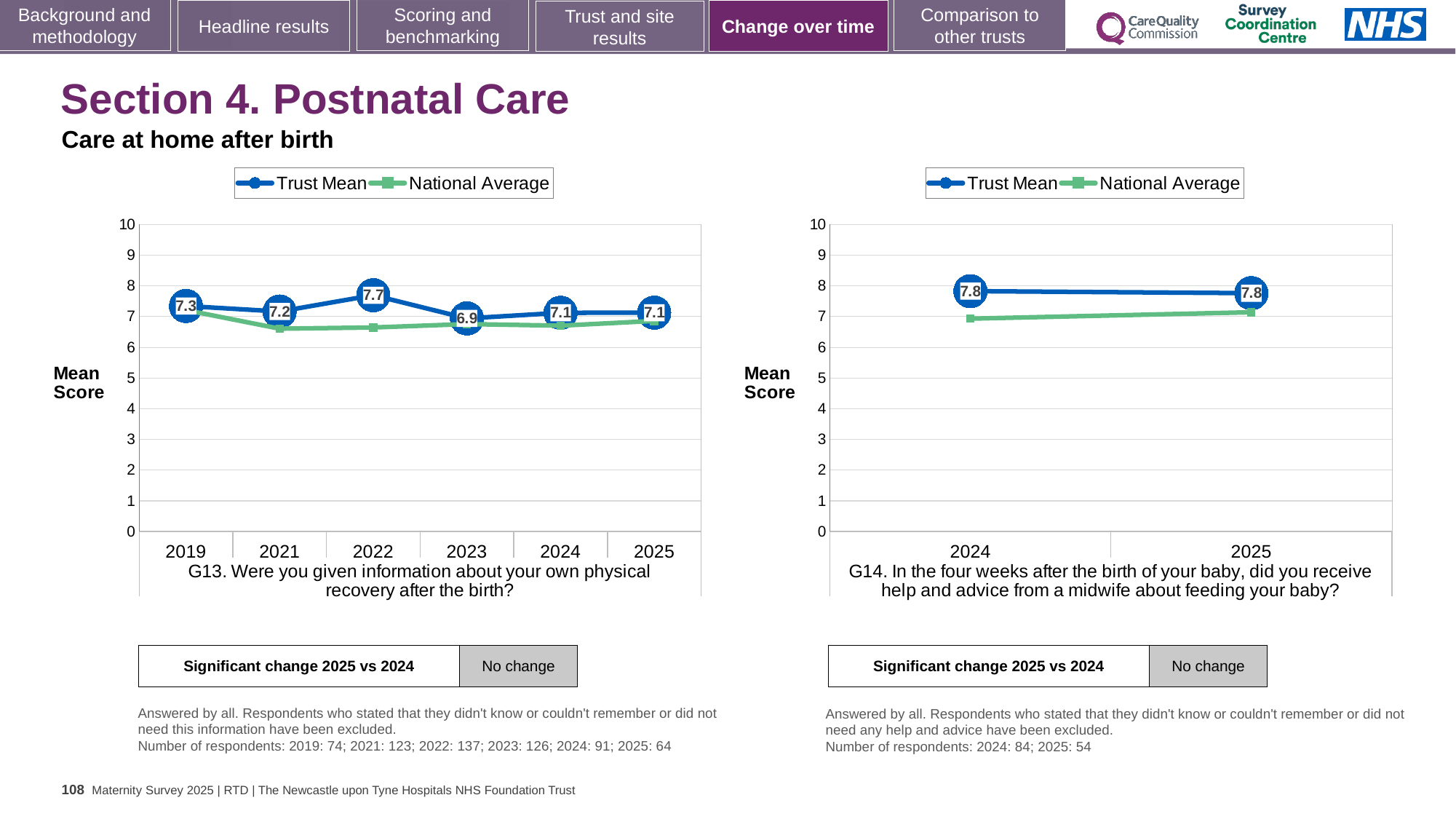
In the G13 chart on the left, what is the difference between the Trust Mean for 2022 and the Trust Mean for 2023? 0.8 How many years are shown on the x axis of the G13 chart on the left? 6 In the G13 chart on the left, does the Trust Mean rise or fall from 2022 to 2023? Fall In the G13 chart on the left, what is the Trust Mean for 2023? 6.9 In the G13 chart on the left, what is the Trust Mean for 2022? 7.7 How many series does the legend of the G14 chart on the right list? 2 In the G14 chart on the right, is the National Average for 2024 greater or less than 8? less What kind of chart is the G13 chart on the left? Line chart In the G14 chart on the right, what is the Trust Mean for 2025? 7.8 In the G13 chart on the left, which year has the highest Trust Mean? 2022 In the G13 chart on the left, which year has the lowest Trust Mean? 2023 In the G13 chart on the left, which is larger, the Trust Mean for 2019 or the Trust Mean for 2021? 2019